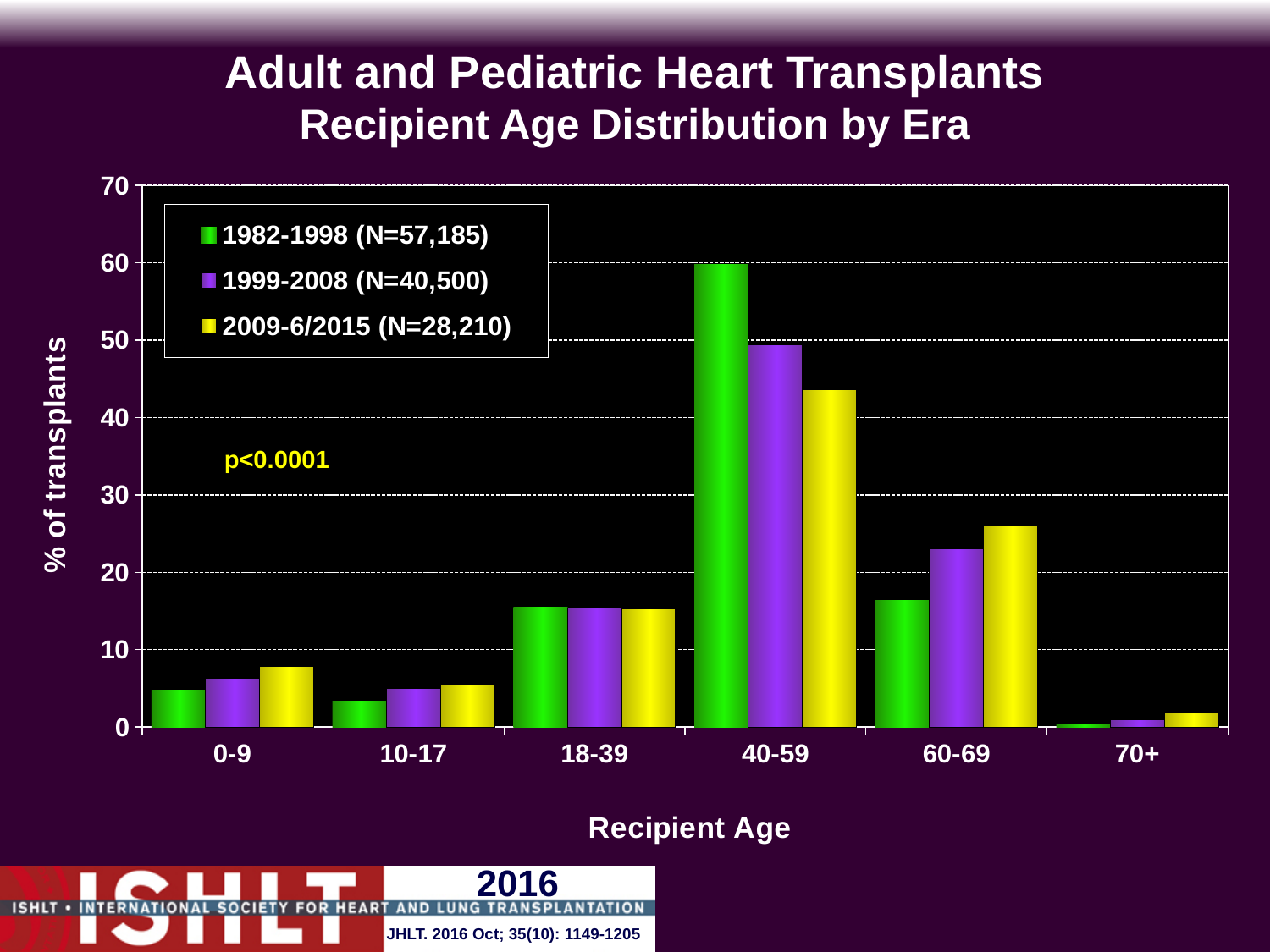
Is the value for 1999-2008 in the 40-59 age group greater or less than 40? greater How many recipient age groups are shown on the x axis? 6 Which recipient age group has the lowest % of transplants for the 2009-6/2015 era? 70+ What kind of chart is shown on the slide? bar chart Is the value for 1982-1998 in the 10-17 age group greater or less than 10? less Which recipient age group has the highest % of transplants for the 1982-1998 era? 40-59 In the 40-59 age group, which era has the larger % of transplants: 1982-1998 or 1999-2008? 1982-1998 In the 60-69 age group, which era has the larger % of transplants: 1982-1998 or 2009-6/2015? 2009-6/2015 In the 60-69 age group, do the values rise or fall from the 1982-1998 era to the 2009-6/2015 era? rise Is the value for 2009-6/2015 in the 60-69 age group greater or less than 20? greater How many series does the legend list? 3 What p-value is printed on the chart? p<0.0001